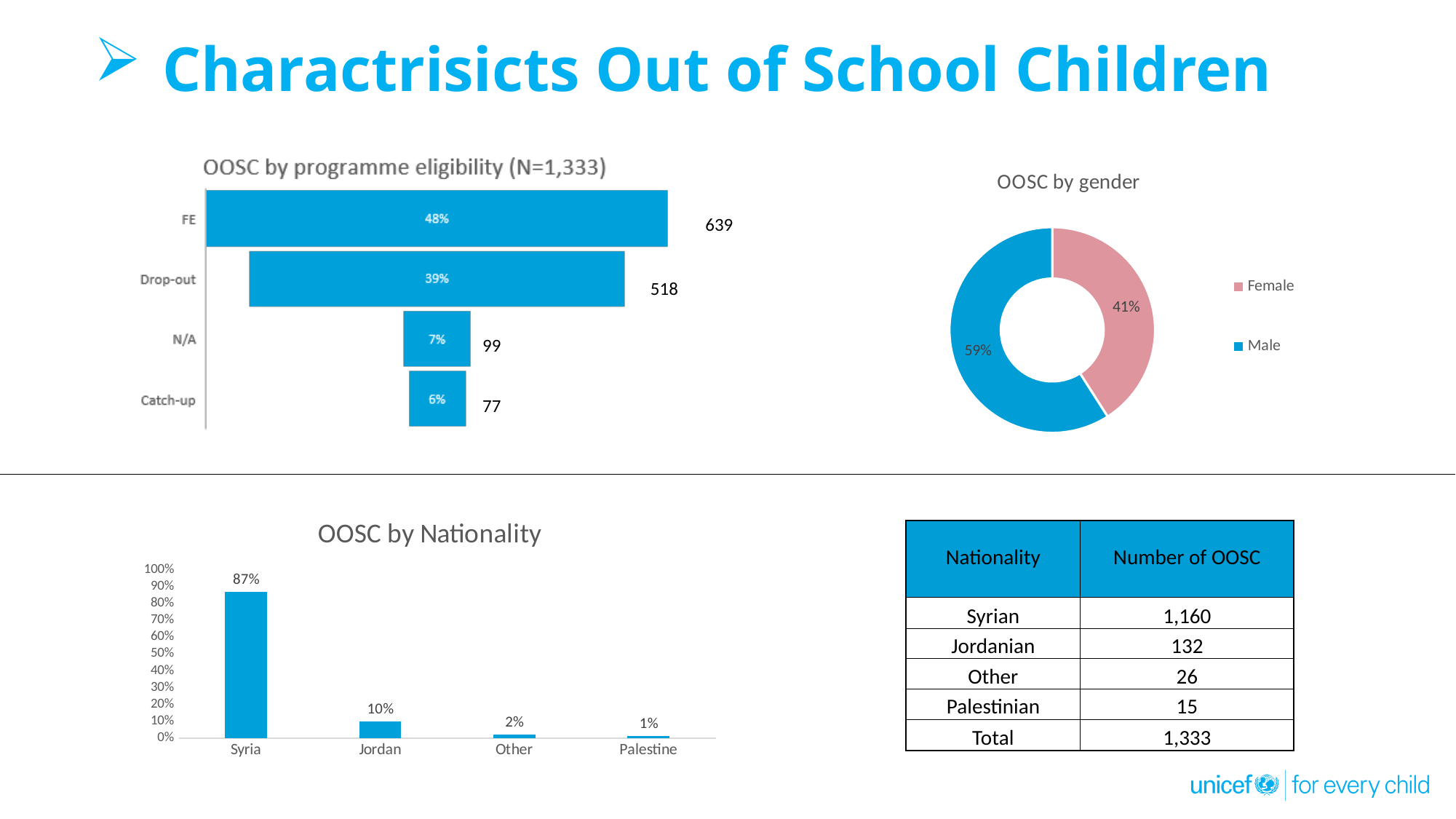
In the 'OOSC by Nationality' chart, what is the difference between the Syria and Jordan percentages? 77% In the 'OOSC by programme eligibility' chart, which category has the lowest value? Catch-up In the 'OOSC by gender' chart, which is larger, Male or Female? Male In the 'OOSC by programme eligibility' chart, what percentage is shown for Drop-out? 39% What kind of chart is 'OOSC by gender'? Pie (doughnut) chart In the 'OOSC by Nationality' chart, which nationality has the highest value? Syria In the 'OOSC by gender' chart, what share is Female? 41% In the 'OOSC by programme eligibility' chart, what is the difference between the FE count and the Drop-out count? 121 How many categories are shown in the 'OOSC by programme eligibility' chart? 4 In the 'OOSC by Nationality' chart, what percentage is shown for Jordan? 10% What kind of chart is 'OOSC by Nationality'? Bar chart In the 'OOSC by programme eligibility' chart, what count is shown next to the FE bar? 639